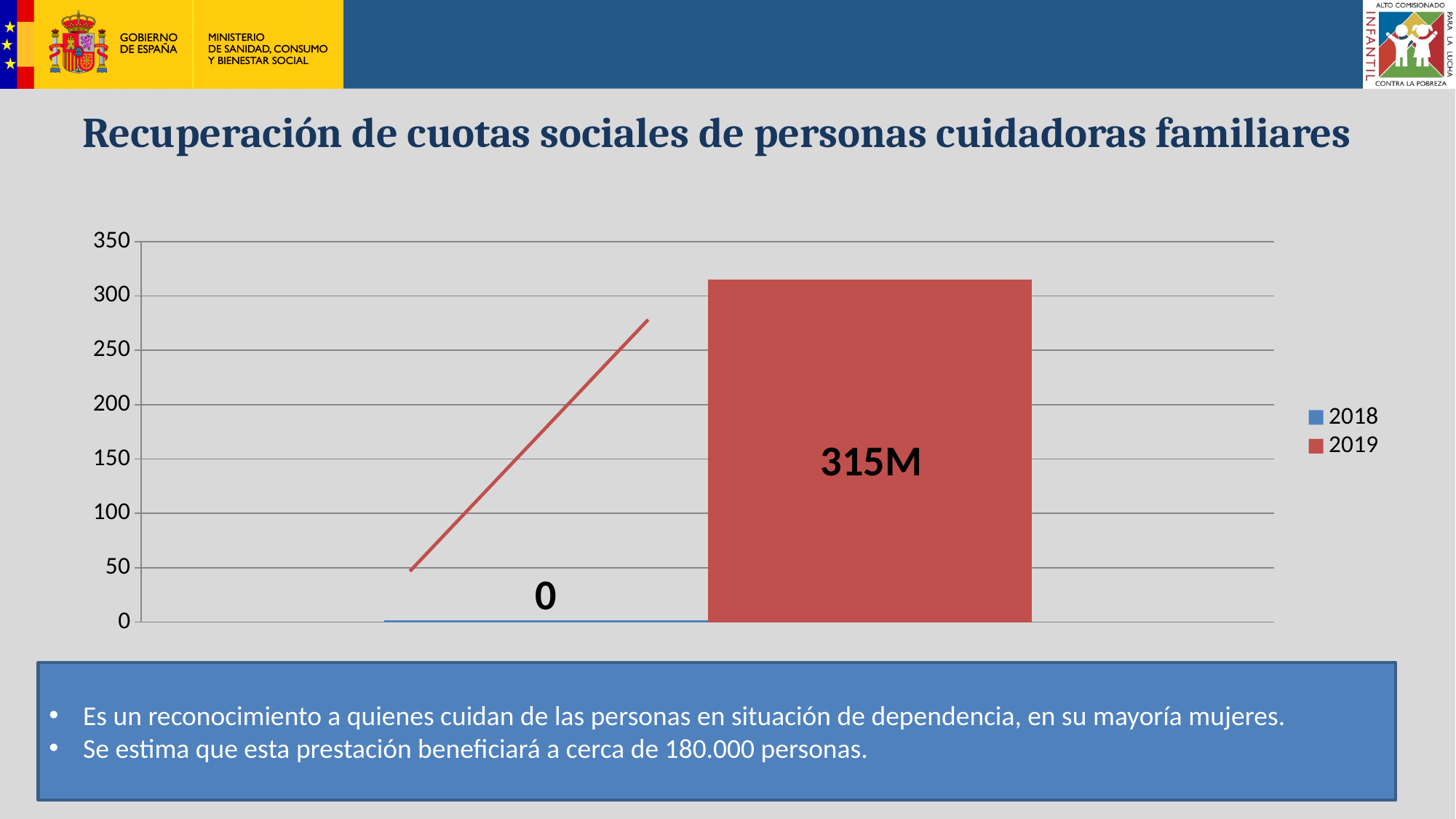
What value is labelled on the 2019 bar? 315M Do the values rise or fall from 2018 to 2019? rise Which series has the lowest value? 2018 How many series does the legend list? 2 What kind of chart is shown on the slide? bar chart What colour is the 2019 bar? red What is the highest value shown on the vertical axis? 350 What is the difference between the 2019 value and the 2018 value? 315M What value is labelled on the 2018 bar? 0 Is the value for 2019 greater or less than 300? greater Which series has the highest value? 2019 Which series has the higher value, 2018 or 2019? 2019